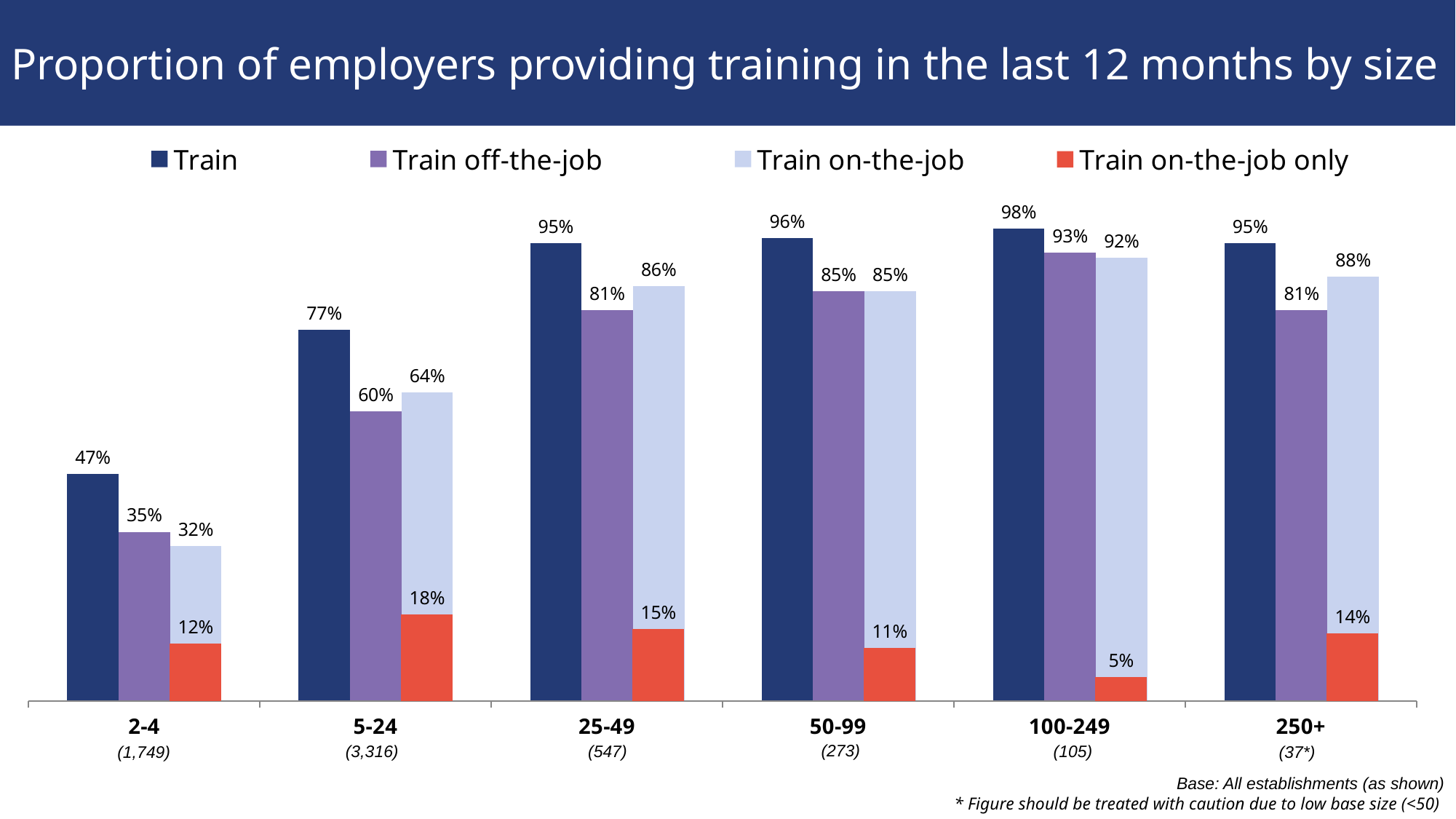
Which size band has the lowest value for Train on-the-job? 2-4 How many size bands are shown on the x axis? 6 Which is larger for the 250+ size band: Train off-the-job or Train on-the-job? Train on-the-job What kind of chart is shown on the slide? Bar chart How many series does the legend list? 4 What is the value for Train off-the-job for the 50-99 size band? 85% What is the value for Train for the 2-4 size band? 47% Which size band has the highest value for Train? 100-249 Does the Train value rise or fall from the 2-4 band to the 100-249 band? Rise What is the difference between the Train value for 5-24 and the Train value for 2-4? 30% Which series is shown in red in the legend? Train on-the-job only What is the value for Train on-the-job only for the 100-249 size band? 5%